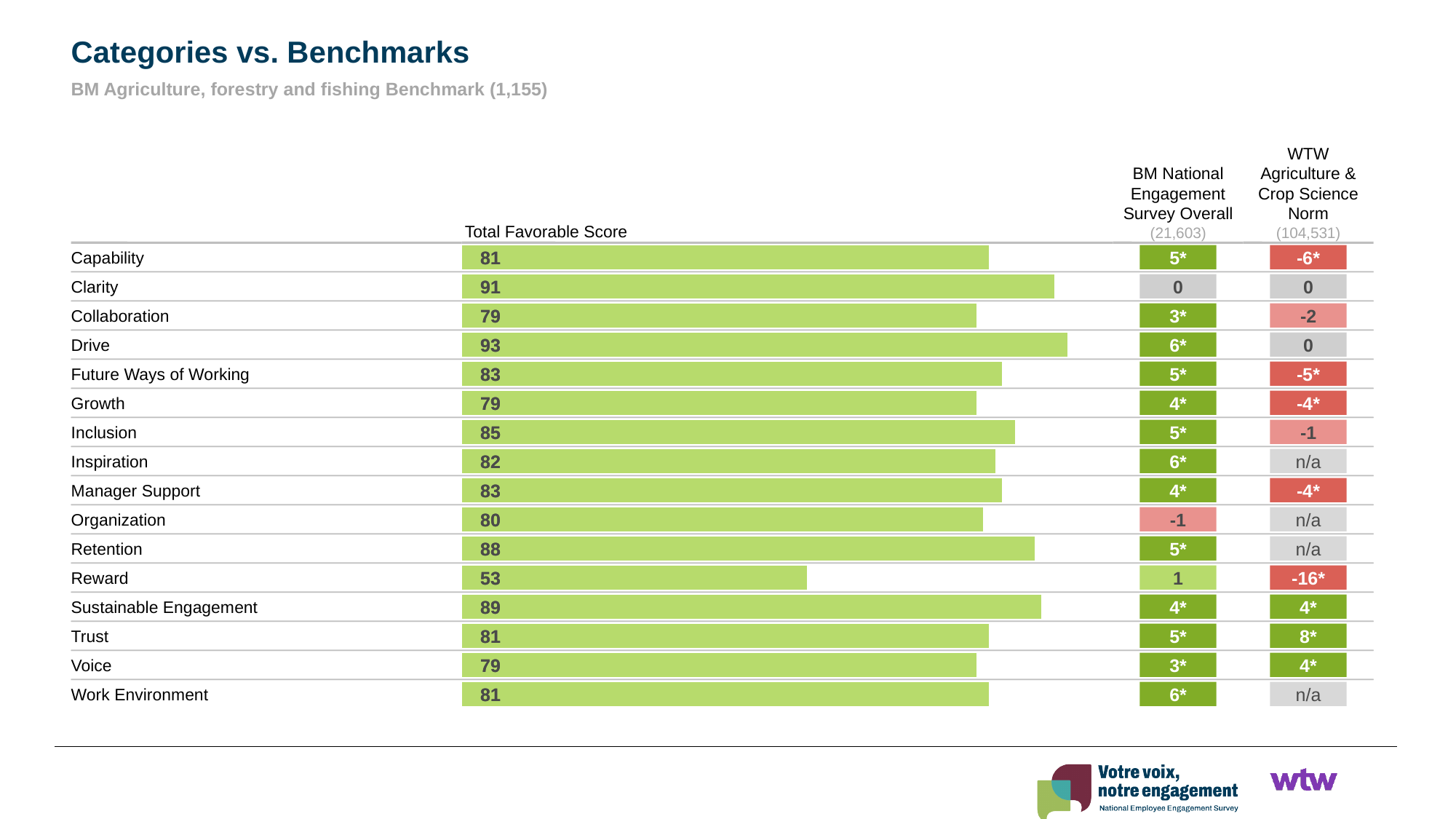
What is the Total Favorable Score for Reward? 53 What is the difference between the Total Favorable Scores for Clarity and Collaboration? 12 What is the Total Favorable Score for Sustainable Engagement? 89 What is the Total Favorable Score for Drive? 93 What kind of chart is used to show the Total Favorable Score? Bar chart Which category has the lowest Total Favorable Score? Reward Which has a higher Total Favorable Score, Retention or Inclusion? Retention What is the value shown for Capability in the BM National Engagement Survey Overall column? 5* What is the title of the slide? Categories vs. Benchmarks Which category has the highest Total Favorable Score? Drive What is the value shown for Reward in the WTW Agriculture & Crop Science Norm column? -16* How many categories are shown in the chart? 16